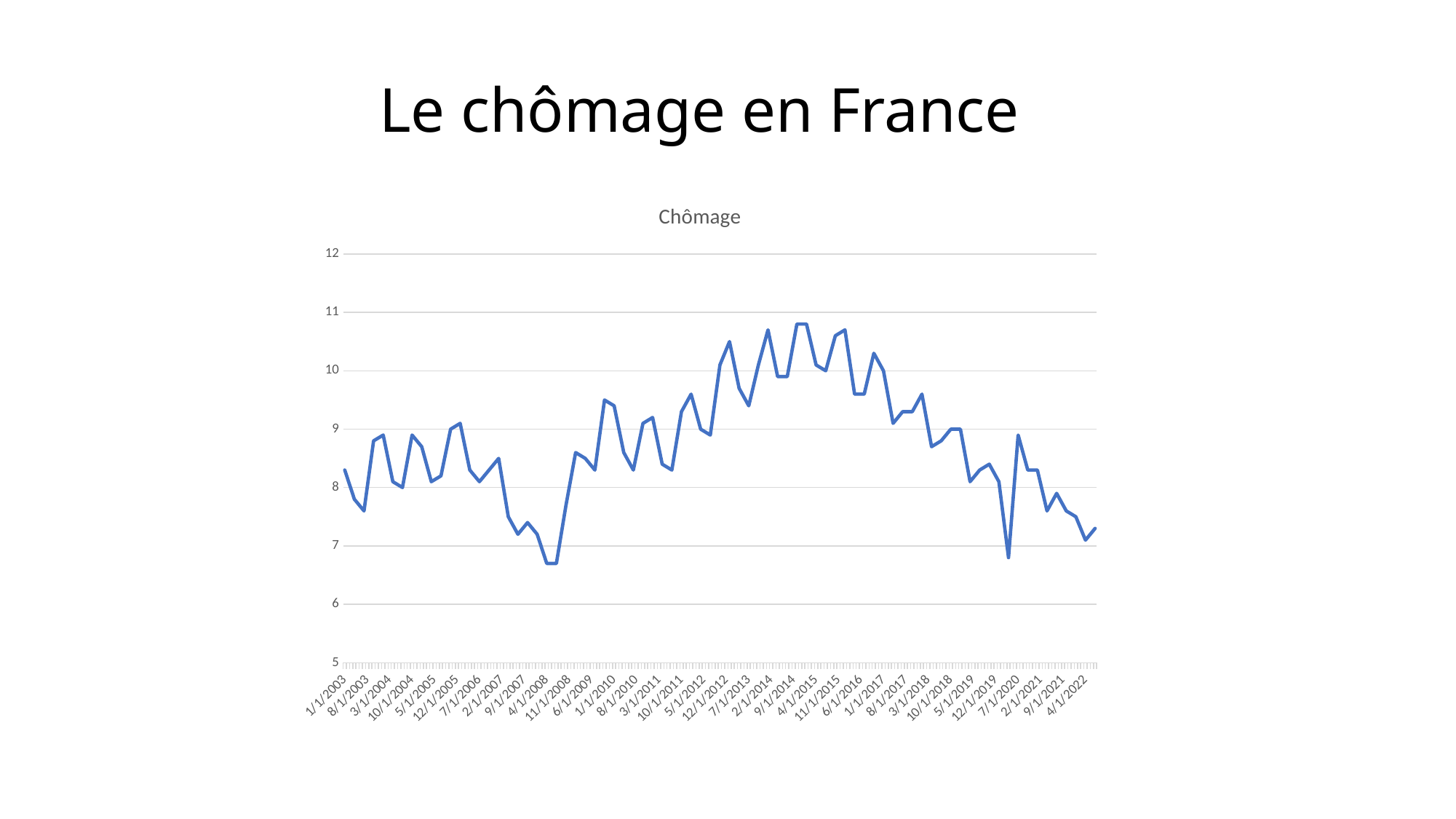
What kind of chart is shown on the slide? line chart Between 4/1/2015 and 4/1/2022, does the line generally rise or fall? fall Between 4/1/2008 and 4/1/2015, does the line generally rise or fall? rise Which is larger, the value at 1/1/2003 or the value at 4/1/2008? 1/1/2003 Is the value at 1/1/2003 greater or less than 9? less Is the value at 7/1/2020 greater or less than 7? greater Is the value at 4/1/2008 greater or less than 7? less What is the title of the slide? Le chômage en France What is the title of the chart? Chômage Which is larger, the value at 4/1/2015 or the value at 4/1/2022? 4/1/2015